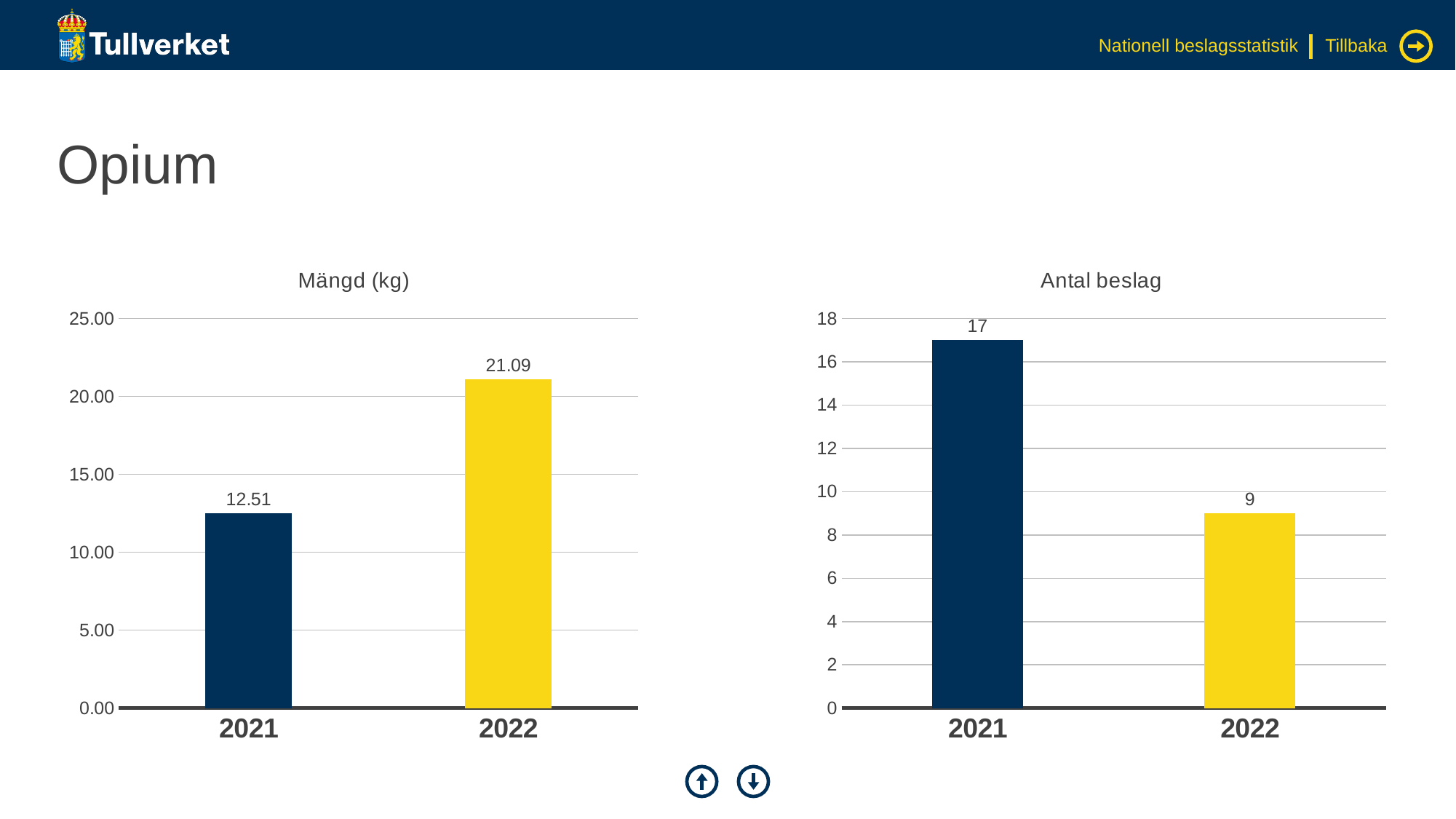
What type of chart is the 'Antal beslag' chart? bar chart In the 'Mängd (kg)' chart, what is the value for 2021? 12.51 In the 'Antal beslag' chart, what is the difference between the 2021 and 2022 values? 8 In the 'Mängd (kg)' chart, what is the difference between the 2022 and 2021 values? 8.58 In the 'Mängd (kg)' chart, how many years are shown on the x axis? 2 In the 'Antal beslag' chart, what is the value for 2021? 17 In the 'Antal beslag' chart, is the value for 2021 greater or less than 10? greater In the 'Antal beslag' chart, do the values rise or fall from 2021 to 2022? fall In the 'Mängd (kg)' chart, which year has the highest value? 2022 In the 'Antal beslag' chart, which year has the lowest value? 2022 In the 'Mängd (kg)' chart, what is the value for 2022? 21.09 In the 'Antal beslag' chart, what is the value for 2022? 9